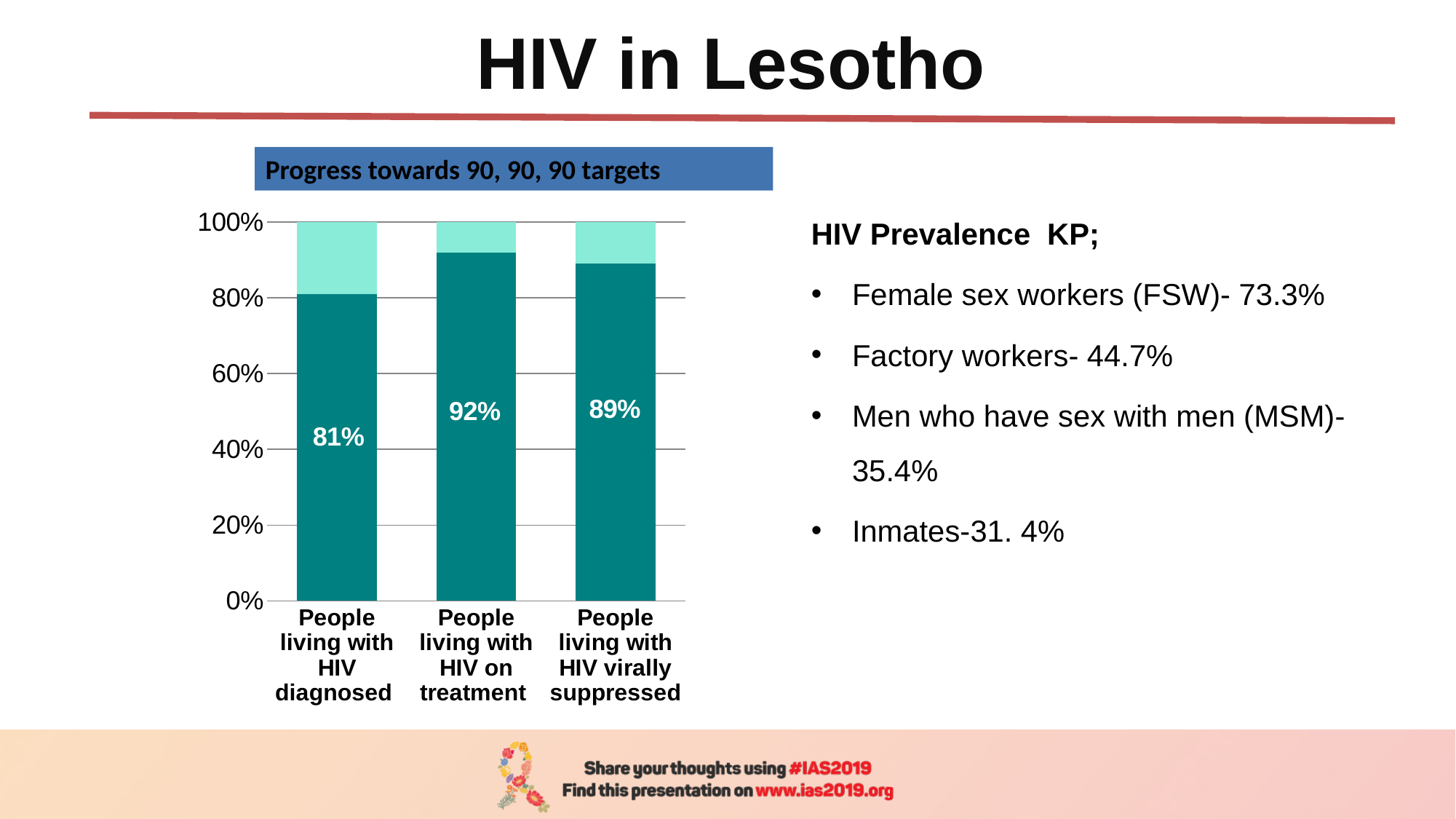
What is the title of the chart? Progress towards 90, 90, 90 targets How many categories are shown on the x axis of the chart? 3 Which category has the lowest labelled value? People living with HIV diagnosed Which is larger: the value for People living with HIV virally suppressed or the value for People living with HIV diagnosed? People living with HIV virally suppressed What is the value shown for People living with HIV diagnosed? 81% What is the value shown for People living with HIV on treatment? 92% What total does each stacked bar reach on the y axis? 100% What is the difference between the value for People living with HIV on treatment and the value for People living with HIV diagnosed? 11 percentage points What kind of chart is shown on the slide? Stacked bar chart What is the value shown for People living with HIV virally suppressed? 89% Is the dark teal value for People living with HIV diagnosed greater or less than 60%? greater Which category has the highest labelled value? People living with HIV on treatment